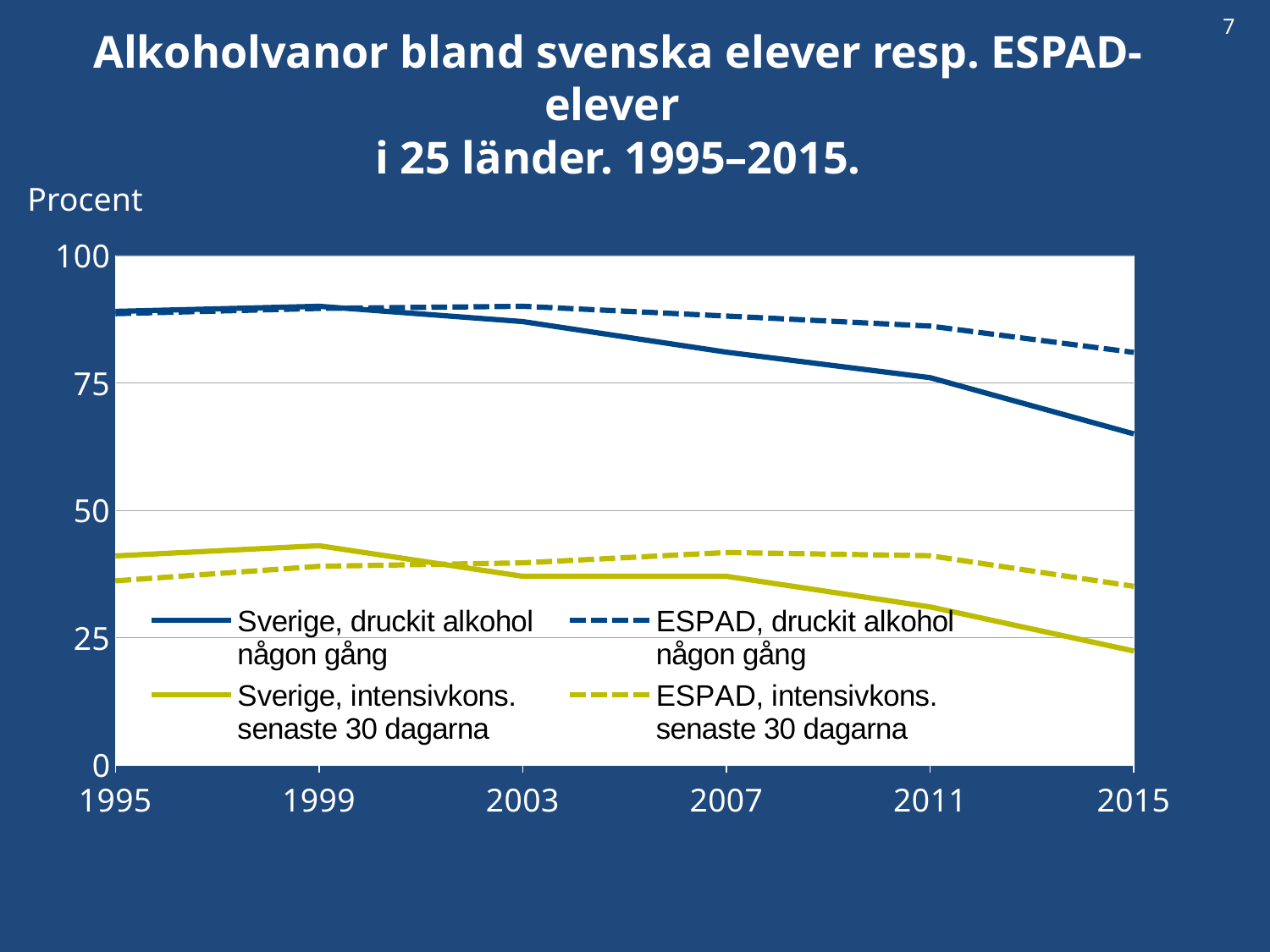
Is the value for "Sverige, intensivkons. senaste 30 dagarna" in 2015 greater or less than 25? less How many years are labelled on the x axis? 6 What kind of chart is shown on the slide? line chart In 2015, which is higher: "Sverige, druckit alkohol någon gång" or "ESPAD, druckit alkohol någon gång"? ESPAD, druckit alkohol någon gång Is the value for "Sverige, intensivkons. senaste 30 dagarna" in 1999 greater or less than 50? less Is the value for "Sverige, druckit alkohol någon gång" in 2015 greater or less than 75? less In 1995, which is higher: "Sverige, intensivkons. senaste 30 dagarna" or "ESPAD, intensivkons. senaste 30 dagarna"? Sverige, intensivkons. senaste 30 dagarna Does the line for "Sverige, druckit alkohol någon gång" rise or fall between 1999 and 2015? fall How many series does the legend list? 4 What unit label is shown above the y axis of the chart? Procent